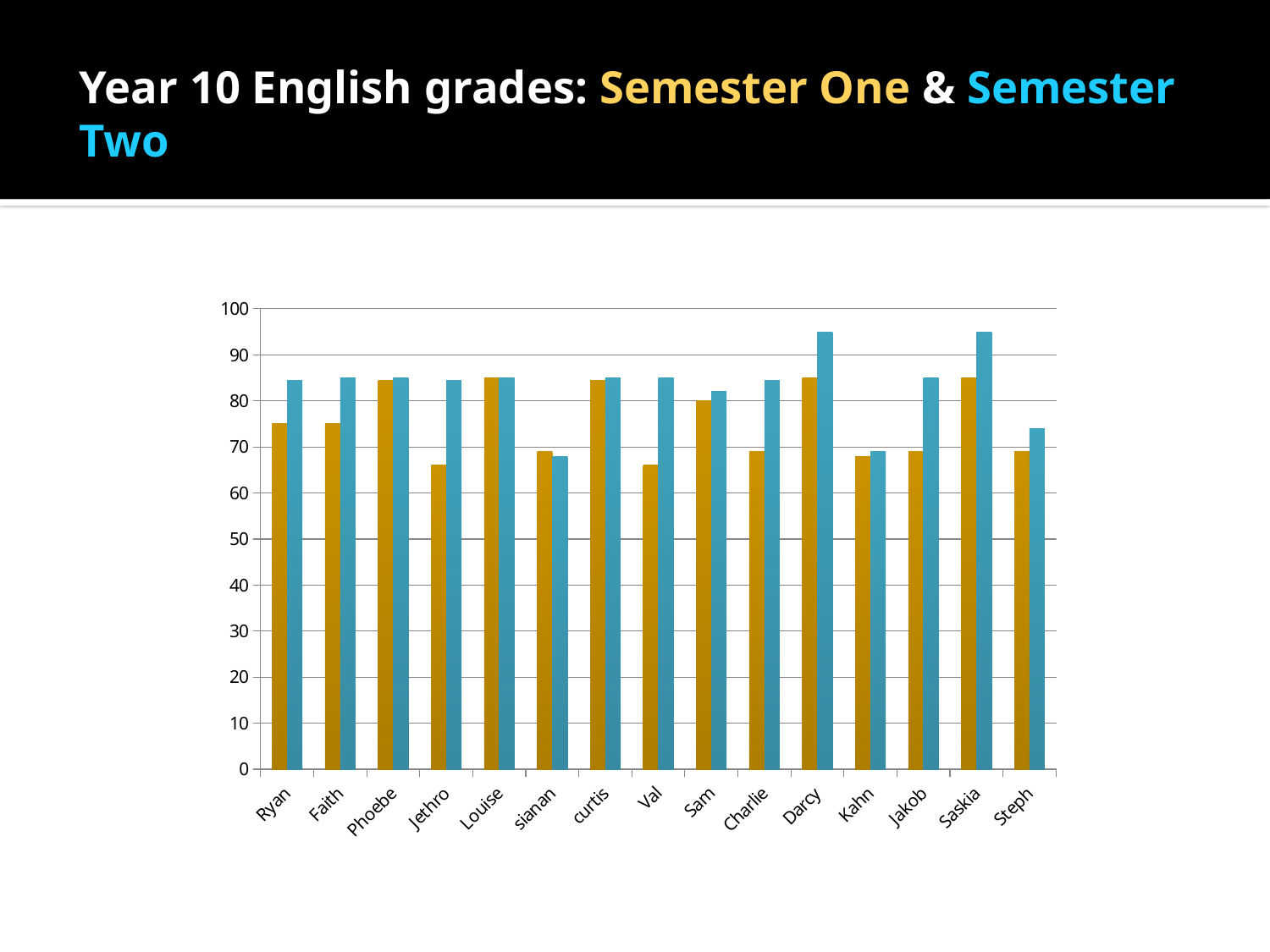
For Jakob, which is larger: the Semester One grade or the Semester Two grade? Semester Two Is Darcy's Semester Two grade greater or less than 90? greater Is Steph's Semester Two grade greater or less than 70? greater Is Jethro's Semester One grade greater or less than 70? less What kind of chart is shown on the slide? bar chart How many students are listed along the x axis of the chart? 15 How many data series does the chart plot? 2 For Jethro, which is larger: the Semester One grade or the Semester Two grade? Semester Two Which colour represents Semester One in the chart? gold